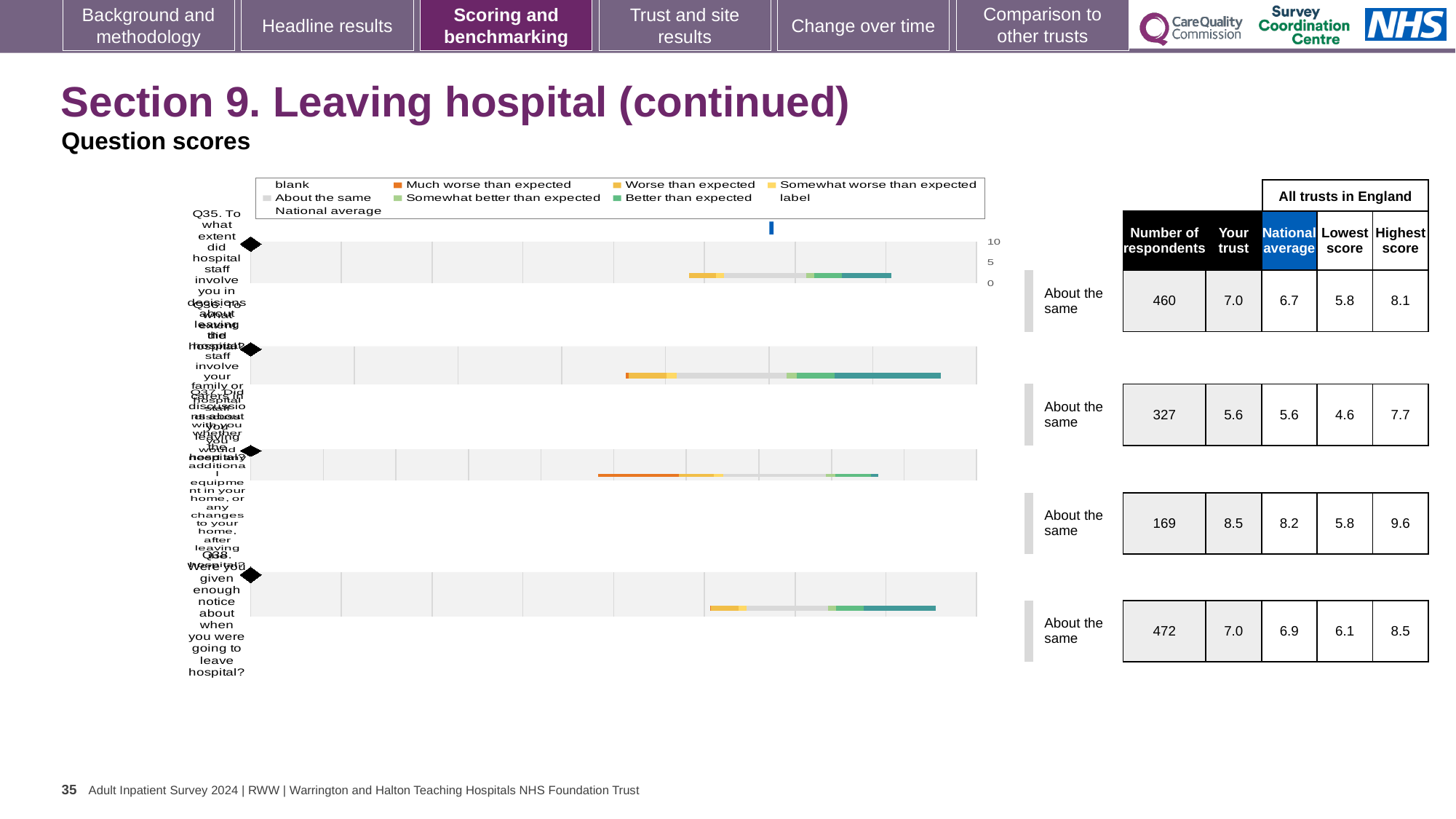
What kind of chart is shown on the slide? bar chart Which row has the lowest number of respondents? Q37 (third row) Which row has the highest 'Your trust' score? Q37 (third row) What colour does the legend use for 'Much worse than expected'? orange What benchmark category is shown next to the Q35 bar? About the same For the third row (Q37), what is the difference between the 'Your trust' score and the national average? 0.3 For Q38 (the last row), what is the difference between the highest score and the lowest score? 2.4 What is the 'Your trust' score for Q35 (the first row)? 7.0 How many question rows are plotted in the chart? 4 For Q35 (the first row), which is larger: the 'Your trust' score or the national average? Your trust What is the number of respondents for Q38 (the last row)? 472 What is the highest score across all trusts in England for the third row (Q37)? 9.6